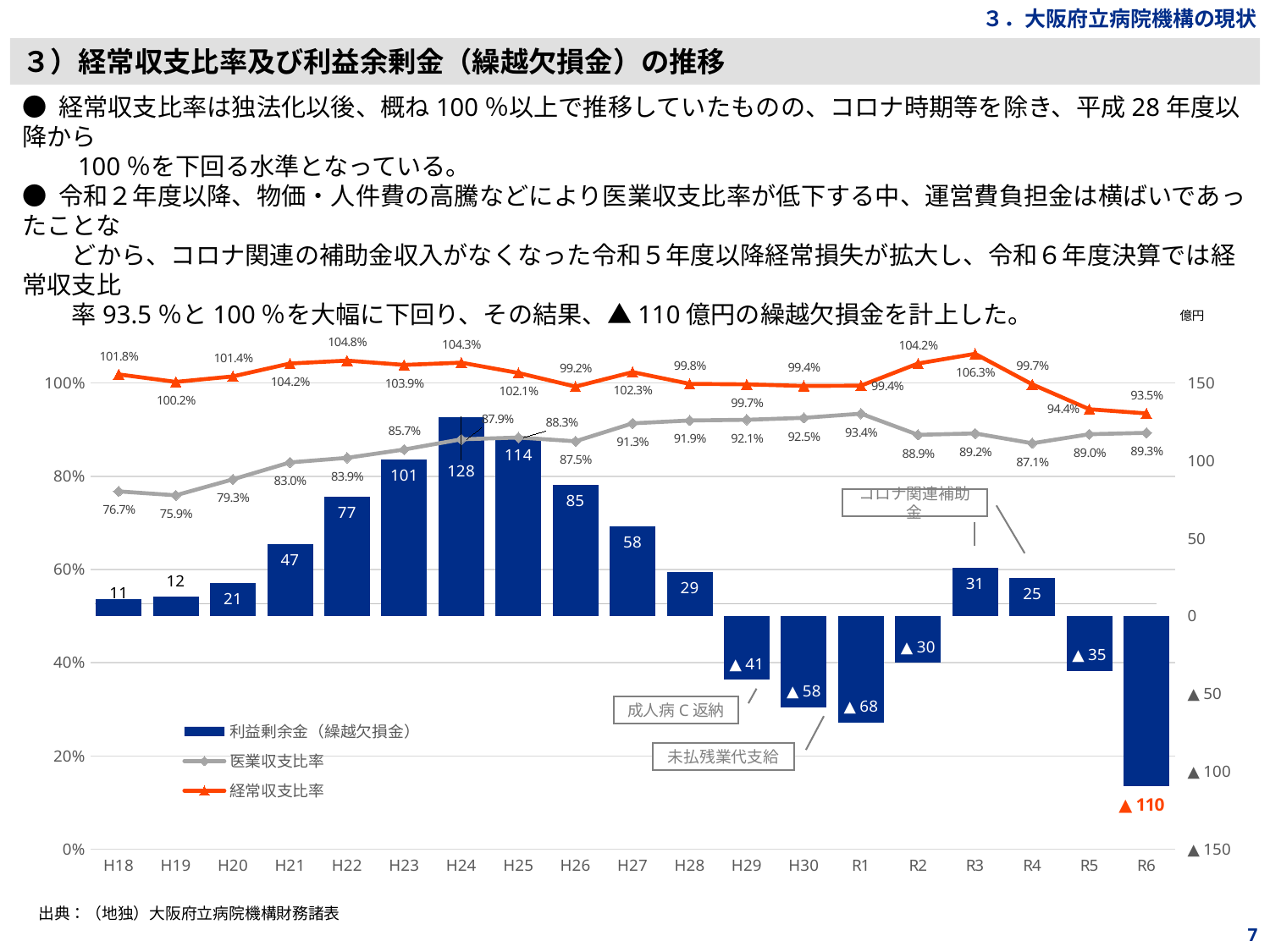
How many years are shown on the x axis of the chart? 19 What is the value of 利益剰余金（繰越欠損金） for R6? ▲110 What kind of chart is shown on the slide? Combined bar and line chart Which year has the highest 経常収支比率 value? R3 What is the difference between the 利益剰余金（繰越欠損金） bars for H24 and H25? 14 How many series does the legend list? 3 Which is larger, the 利益剰余金（繰越欠損金） bar for H23 or for H26? H23 Does the 医業収支比率 line rise or fall from H18 to R1? Rise Which year has the lowest 医業収支比率 value? H19 What is the 医業収支比率 value for H18? 76.7% Which year has the highest 利益剰余金（繰越欠損金） bar? H24 What is the 経常収支比率 value for R3? 106.3%